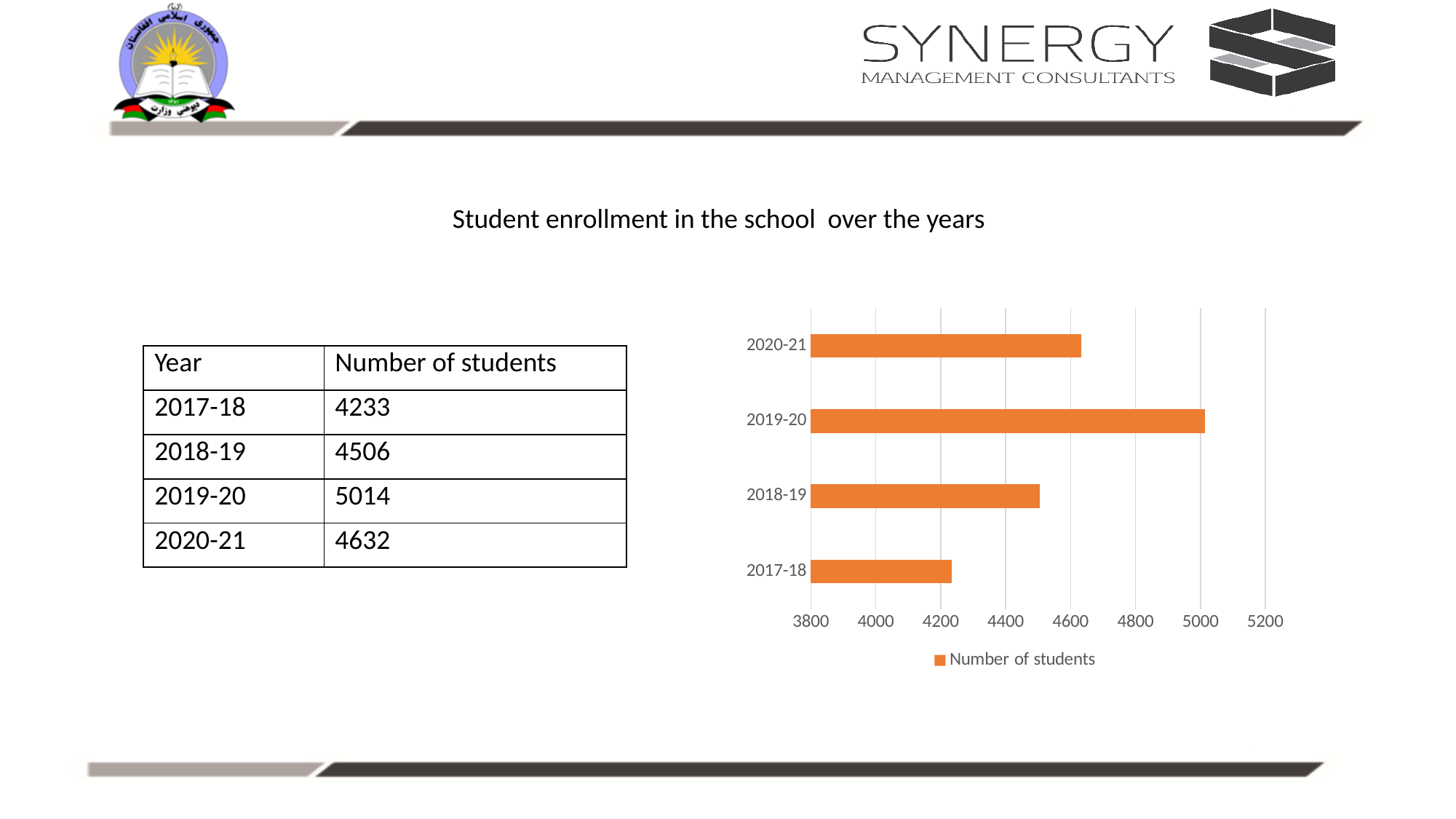
How many years (categories) does the bar chart show? 4 Which year has the lowest number of students? 2017-18 Is the number of students for 2019-20 greater or less than 5000? greater What is the difference in the number of students between 2019-20 and 2017-18? 781 What is the number of students for 2020-21? 4632 Is the number of students for 2018-19 greater or less than 4600? less Which year has the highest number of students? 2019-20 What kind of chart is shown on the slide? bar chart How many series does the chart legend list? 1 Which year has more students, 2018-19 or 2020-21? 2020-21 What is the name of the series shown in the chart legend? Number of students What is the number of students for 2019-20? 5014